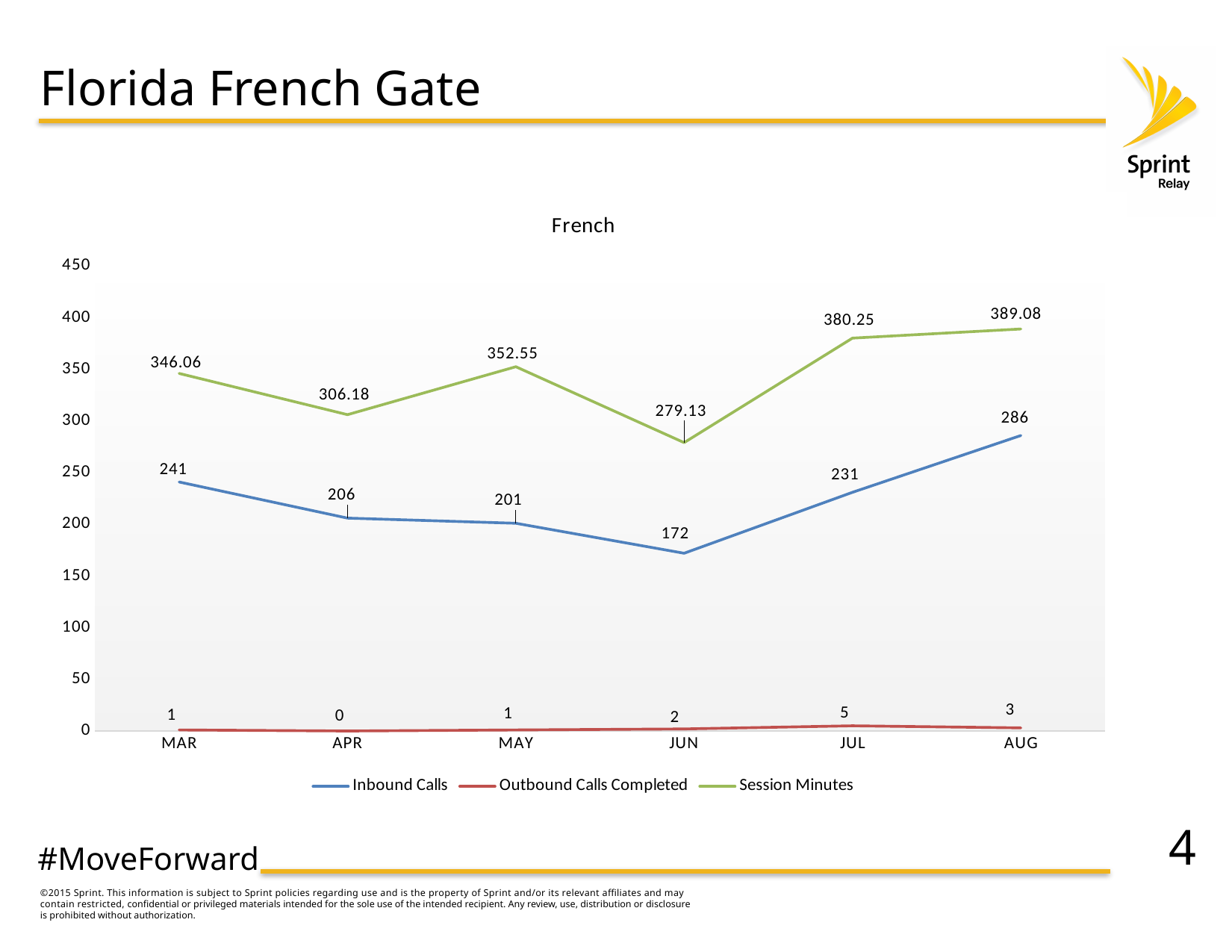
What kind of chart is shown on the slide? Line chart What is the value of Session Minutes in AUG? 389.08 What is the title of the chart? French What is the value of Outbound Calls Completed in JUL? 5 How many series does the legend list? 3 In which month are Inbound Calls highest? AUG Which is larger: Session Minutes in MAR or Session Minutes in MAY? Session Minutes in MAY What is the difference between Inbound Calls in AUG and in JUN? 114 Is the value of Session Minutes in JUL greater or less than 350? greater In which month are Session Minutes lowest? JUN How many months are shown on the x axis? 6 What is the value of Inbound Calls in JUN? 172